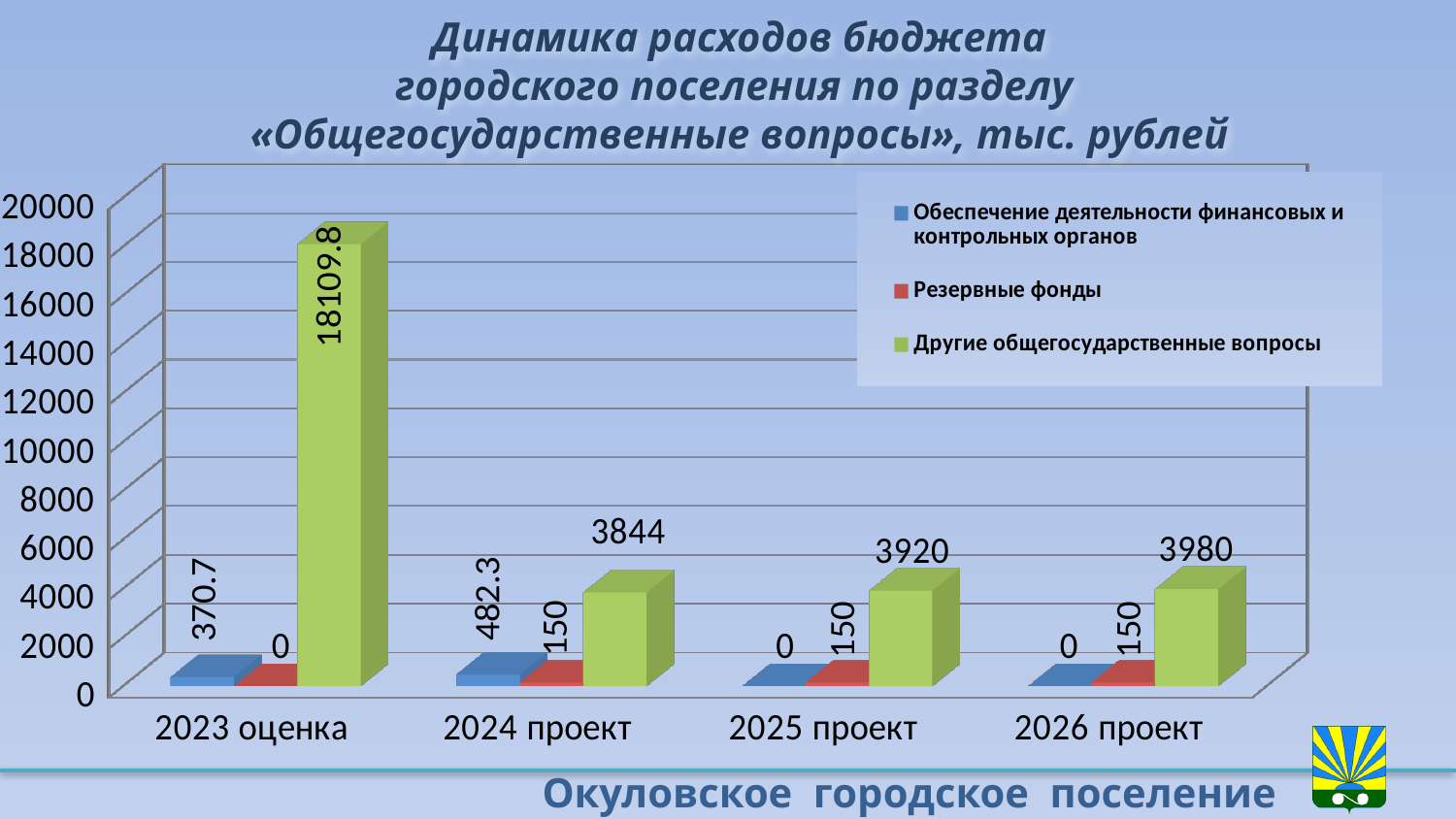
What is the value for «Резервные фонды» in 2025 проект? 150 Is the value for «Другие общегосударственные вопросы» in 2023 оценка greater or less than 16000? greater What is the difference between the «Другие общегосударственные вопросы» values for 2026 проект and 2025 проект? 60 What is the value for «Другие общегосударственные вопросы» in 2023 оценка? 18109.8 Which is larger: the «Обеспечение деятельности финансовых и контрольных органов» value for 2023 оценка or for 2024 проект? 2024 проект In which year is the value for «Другие общегосударственные вопросы» the lowest? 2024 проект What is the value for «Обеспечение деятельности финансовых и контрольных органов» in 2024 проект? 482.3 What is the value for «Другие общегосударственные вопросы» in 2026 проект? 3980 How many year categories are shown on the x axis? 4 How many series does the legend list? 3 What kind of chart is shown on the slide? Bar chart In which year is the value for «Другие общегосударственные вопросы» the highest? 2023 оценка